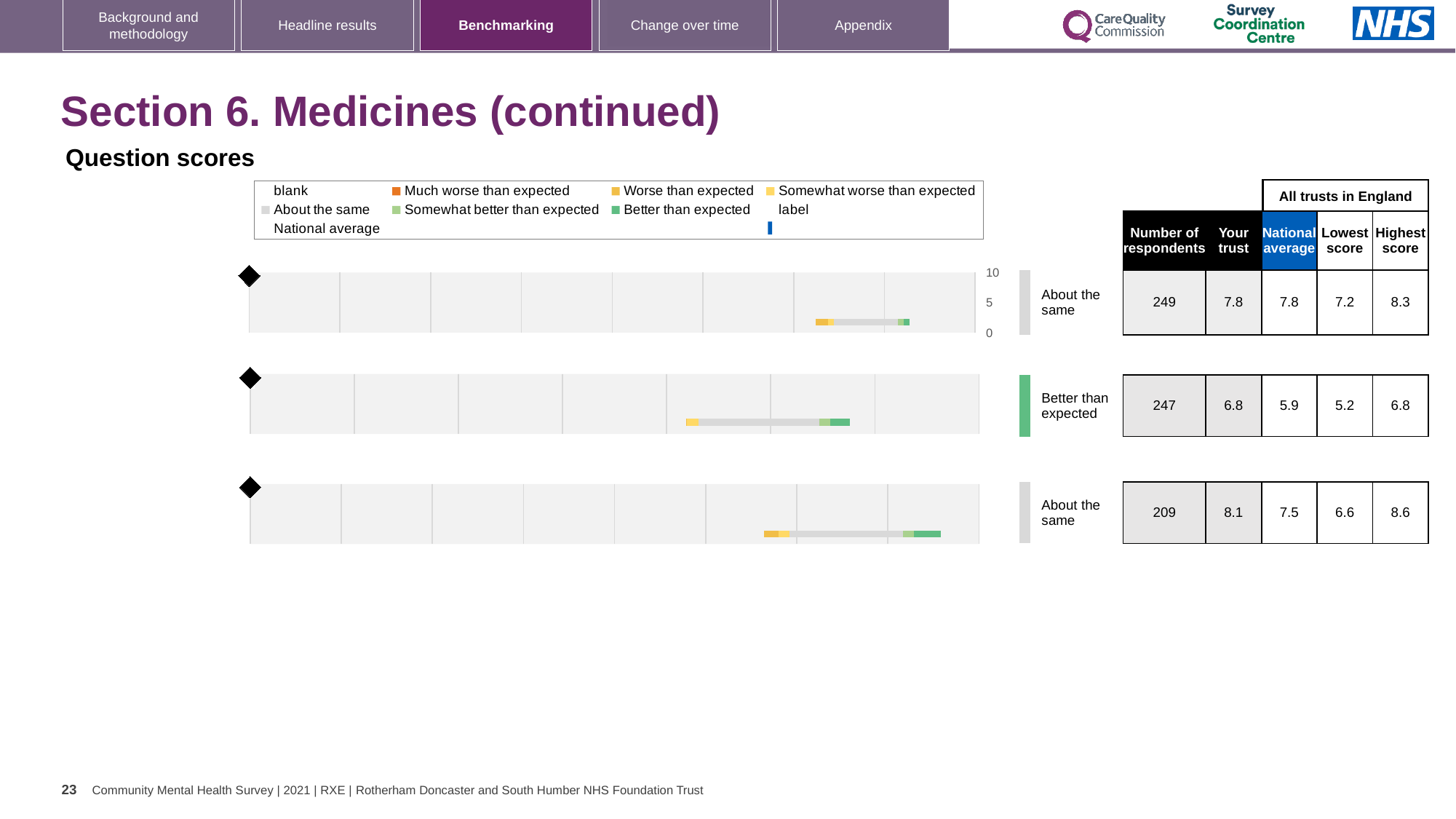
How many question score charts are shown on the slide? 3 For the middle chart, how many respondents are there? 247 For the middle chart, which is larger: the 'Your trust' score or the national average? Your trust For the top chart, what is the 'Your trust' score? 7.8 What kind of chart is used for the question scores on this slide? bar chart Which chart has the highest 'Your trust' score? the bottom chart (8.1) For the bottom chart, what is the highest score among all trusts in England? 8.6 What is the maximum value shown on the score axis of the charts? 10 Which chart has the lowest number of respondents? the bottom chart (209) For the middle chart, what is the national average score? 5.9 What benchmark category is shown next to the middle chart? Better than expected For the bottom chart, what is the difference between the 'Your trust' score and the national average? 0.6